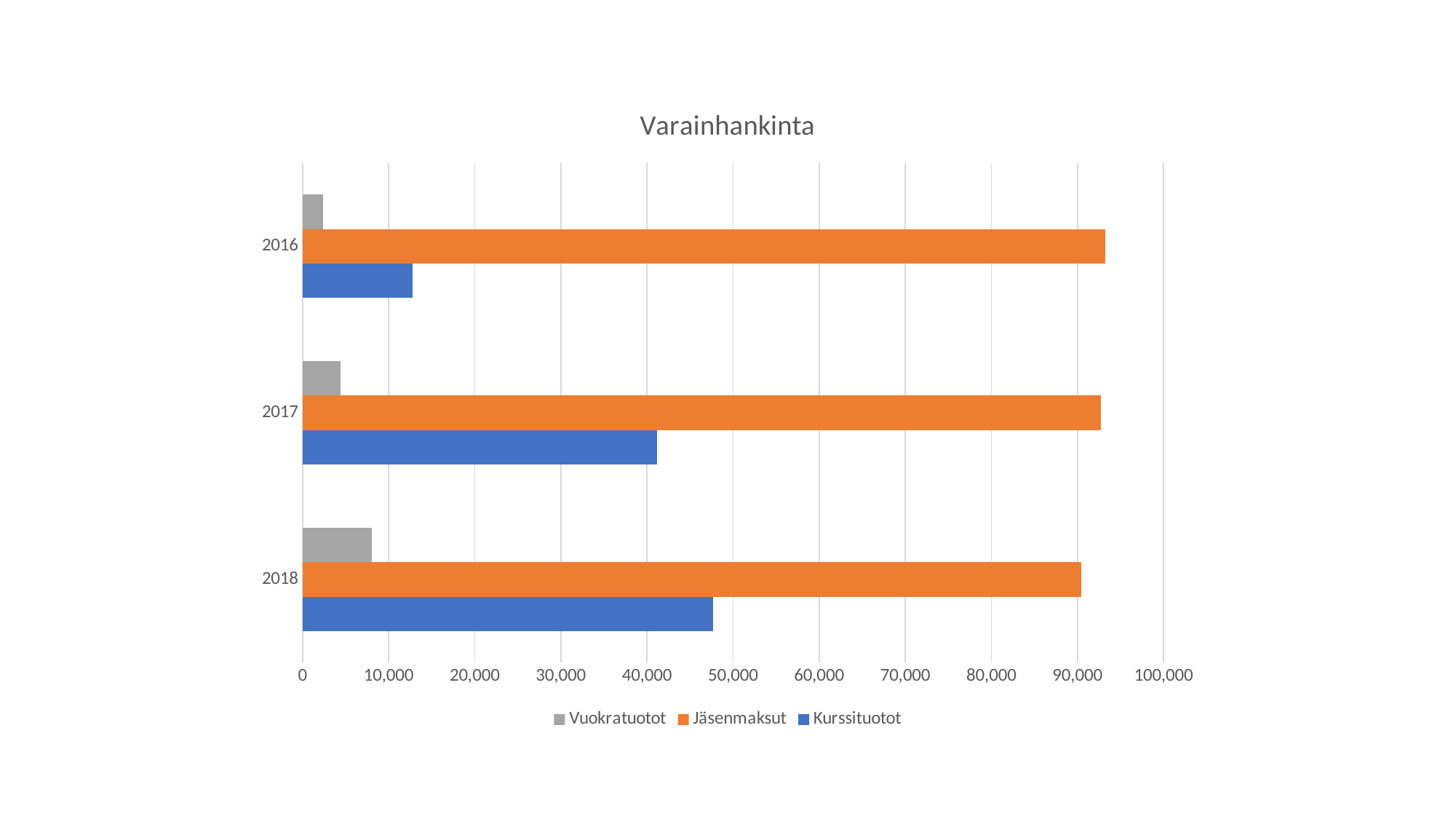
How many series does the legend list? 3 Is the value for Kurssituotot in 2018 greater or less than 40,000? greater What kind of chart is shown on the slide? bar chart Which series has the highest value in 2018? Jäsenmaksut What is the title of the chart? Varainhankinta Which series has the lowest value in 2016? Vuokratuotot Which series is represented by the orange bars? Jäsenmaksut Is the value for Kurssituotot in 2016 greater or less than 20,000? less Which is larger, Kurssituotot in 2017 or Kurssituotot in 2016? Kurssituotot in 2017 Is the value for Jäsenmaksut in 2017 greater or less than 90,000? greater How many years are shown on the chart? 3